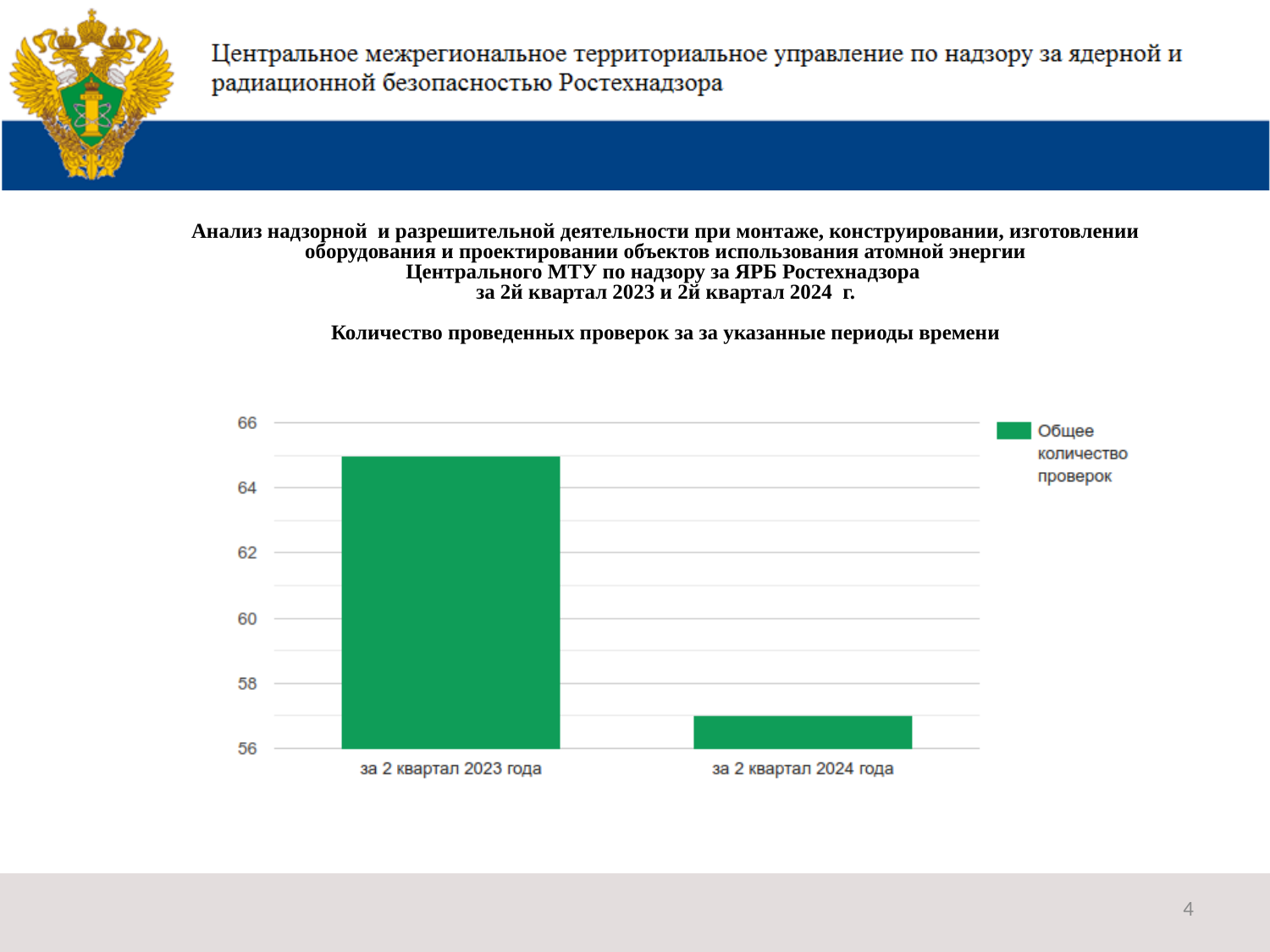
Is the value for за 2 квартал 2023 года greater or less than 64? greater How many series does the chart legend list? 1 Which is larger: the value for за 2 квартал 2023 года or the value for за 2 квартал 2024 года? за 2 квартал 2023 года Which category has the lowest value in the chart? за 2 квартал 2024 года What colour are the bars in the chart? green What kind of chart is shown on the slide? bar chart How many categories are shown on the x axis of the chart? 2 Is the value for за 2 квартал 2024 года greater or less than 58? less Which category has the highest value in the chart? за 2 квартал 2023 года Is the value for за 2 квартал 2024 года greater or less than 60? less Do the values rise or fall from за 2 квартал 2023 года to за 2 квартал 2024 года? fall What is the name of the series shown in the chart legend? Общее количество проверок